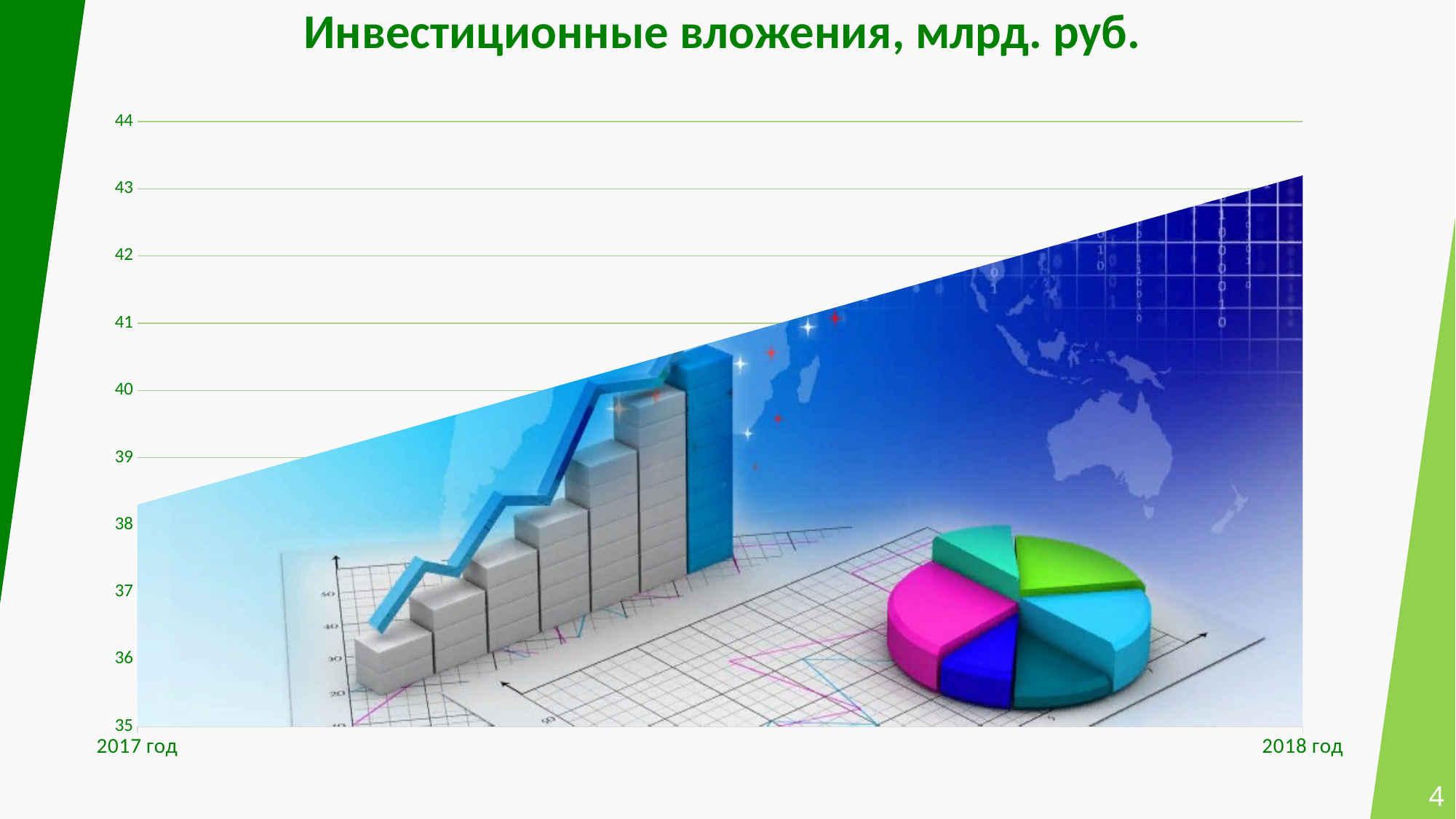
Which year has the higher investment value, 2017 год or 2018 год? 2018 год Which year has the highest investment value on the chart? 2018 год How many years are plotted on the x axis of the chart? 2 Is the value for 2018 год greater or less than 44? less Is the value for 2017 год greater or less than 39? less What is the lowest value shown on the vertical axis of the chart? 35 Is the value for 2017 год greater or less than 38? greater What kind of chart is shown on the slide? area chart What is the title of the chart? Инвестиционные вложения, млрд. руб. Do the investment values rise or fall from 2017 год to 2018 год? rise Which year has the lowest investment value on the chart? 2017 год